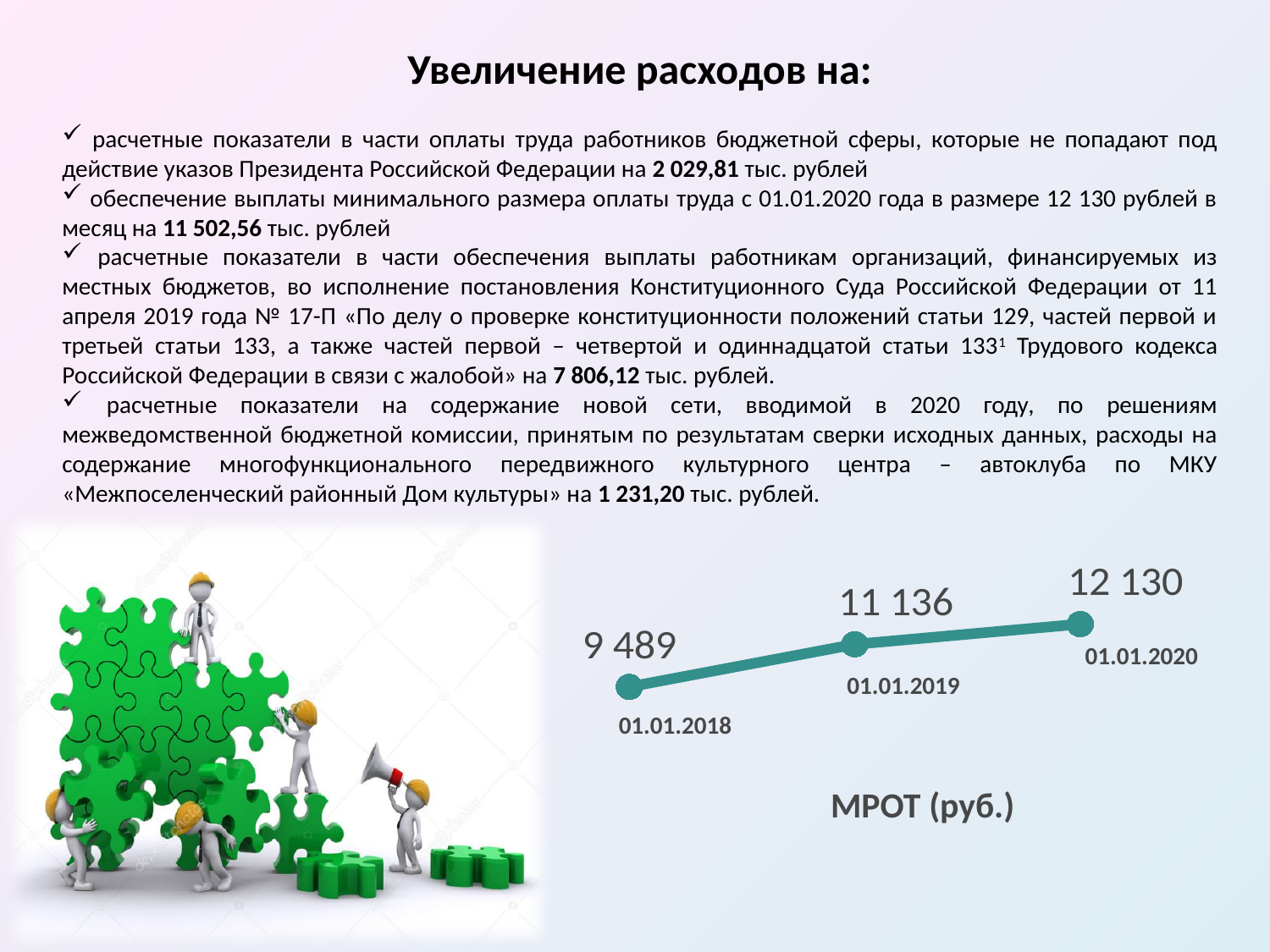
Do the values on the МРОТ (руб.) chart rise or fall from 01.01.2018 to 01.01.2020? rise What is the difference between the values for 01.01.2019 and 01.01.2018 on the МРОТ (руб.) chart? 1 647 Which is larger on the МРОТ (руб.) chart: the value for 01.01.2018 or for 01.01.2019? 01.01.2019 How many data points are plotted on the МРОТ (руб.) chart? 3 What is the value for 01.01.2018 on the МРОТ (руб.) chart? 9 489 Which date has the lowest value on the МРОТ (руб.) chart? 01.01.2018 Which date has the highest value on the МРОТ (руб.) chart? 01.01.2020 What is the value for 01.01.2019 on the МРОТ (руб.) chart? 11 136 What is the title of the chart on the slide? МРОТ (руб.) What is the difference between the values for 01.01.2020 and 01.01.2019 on the МРОТ (руб.) chart? 994 What kind of chart is the МРОТ (руб.) chart? line chart What is the value for 01.01.2020 on the МРОТ (руб.) chart? 12 130